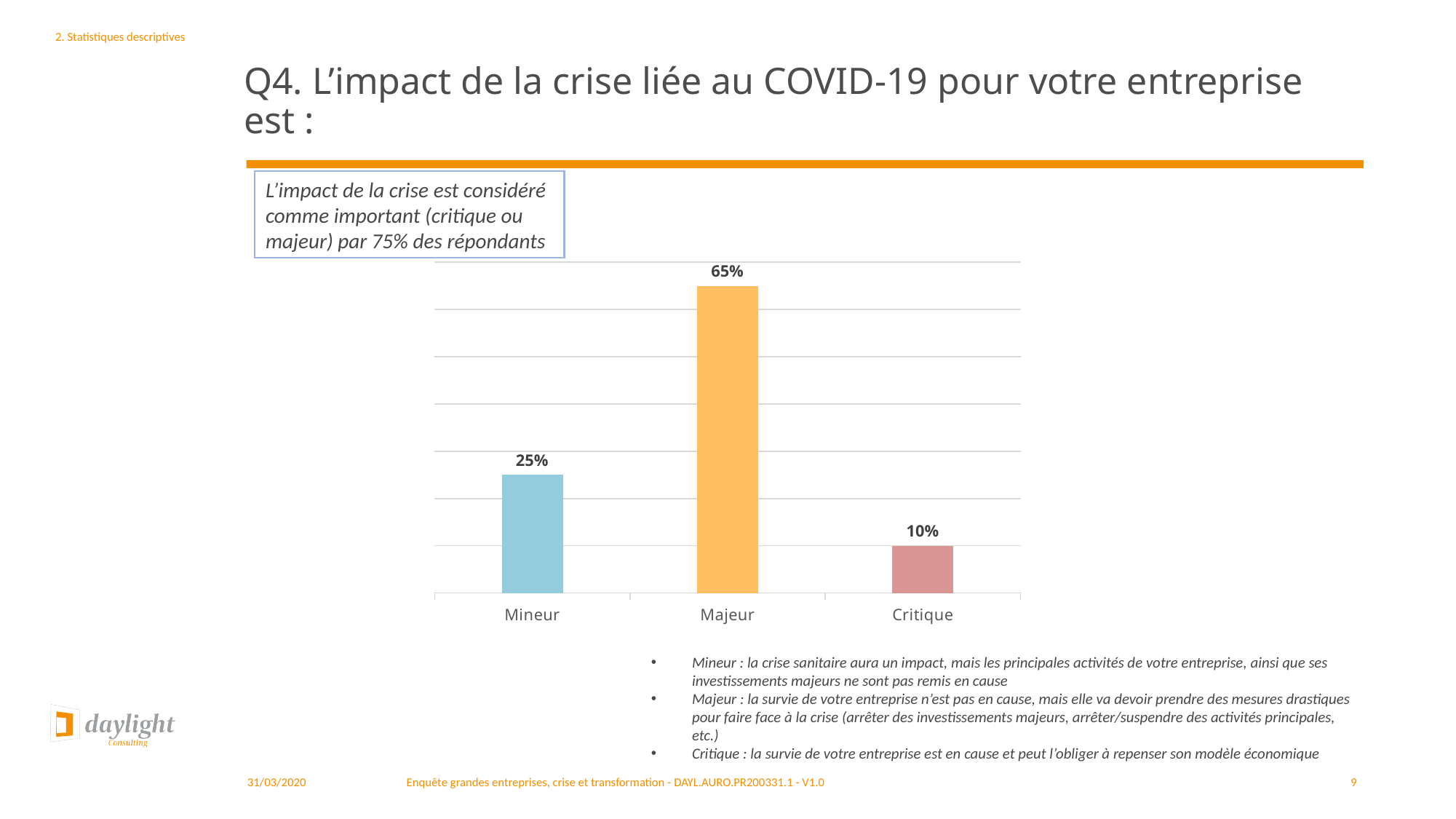
Which is larger, the value for Mineur or the value for Critique? Mineur What is the value for Mineur? 25% Which category has the highest value? Majeur How many categories are shown on the x axis? 3 What is the difference between the values for Majeur and Mineur? 40% What colour is the bar for Majeur? Orange What is the difference between the values for Mineur and Critique? 15% What is the combined value of Majeur and Critique? 75% What is the value for Majeur? 65% What is the value for Critique? 10% What kind of chart is shown on the slide? Bar chart Which category has the lowest value? Critique